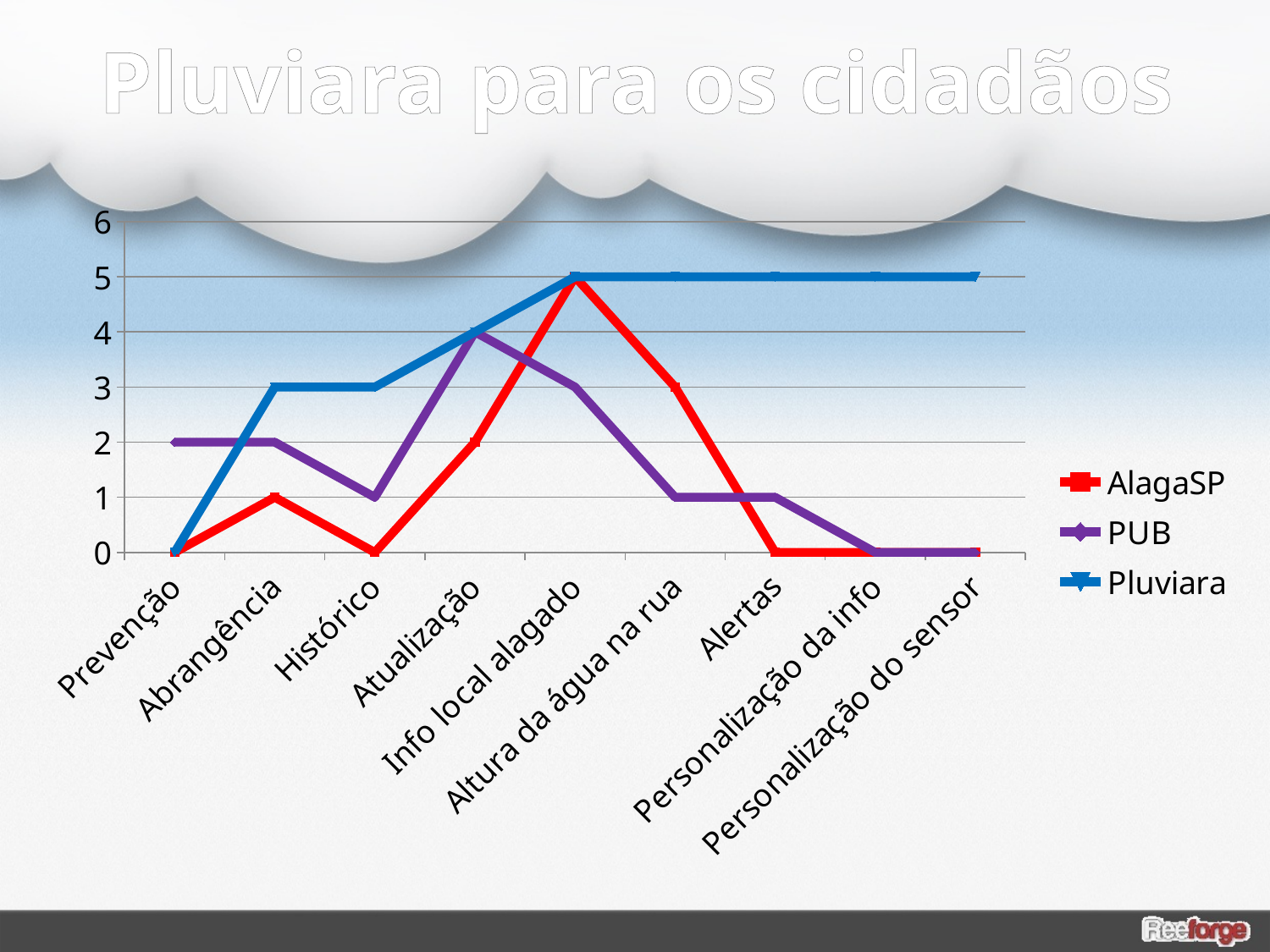
What kind of chart is shown on the slide? line chart How many series does the legend list? 3 At which category does AlagaSP reach its highest value? Info local alagado How many categories are shown on the x axis? 9 Which series has the higher value at Histórico, Pluviara or PUB? Pluviara What is the difference between the Pluviara and AlagaSP values at Altura da água na rua? 2 Which series is drawn in blue? Pluviara What is the value for PUB at Prevenção? 2 What is the value for PUB at Atualização? 4 What is the value for AlagaSP at Info local alagado? 5 Does the Pluviara line rise or fall from Prevenção to Info local alagado? rise What is the value for Pluviara at Alertas? 5